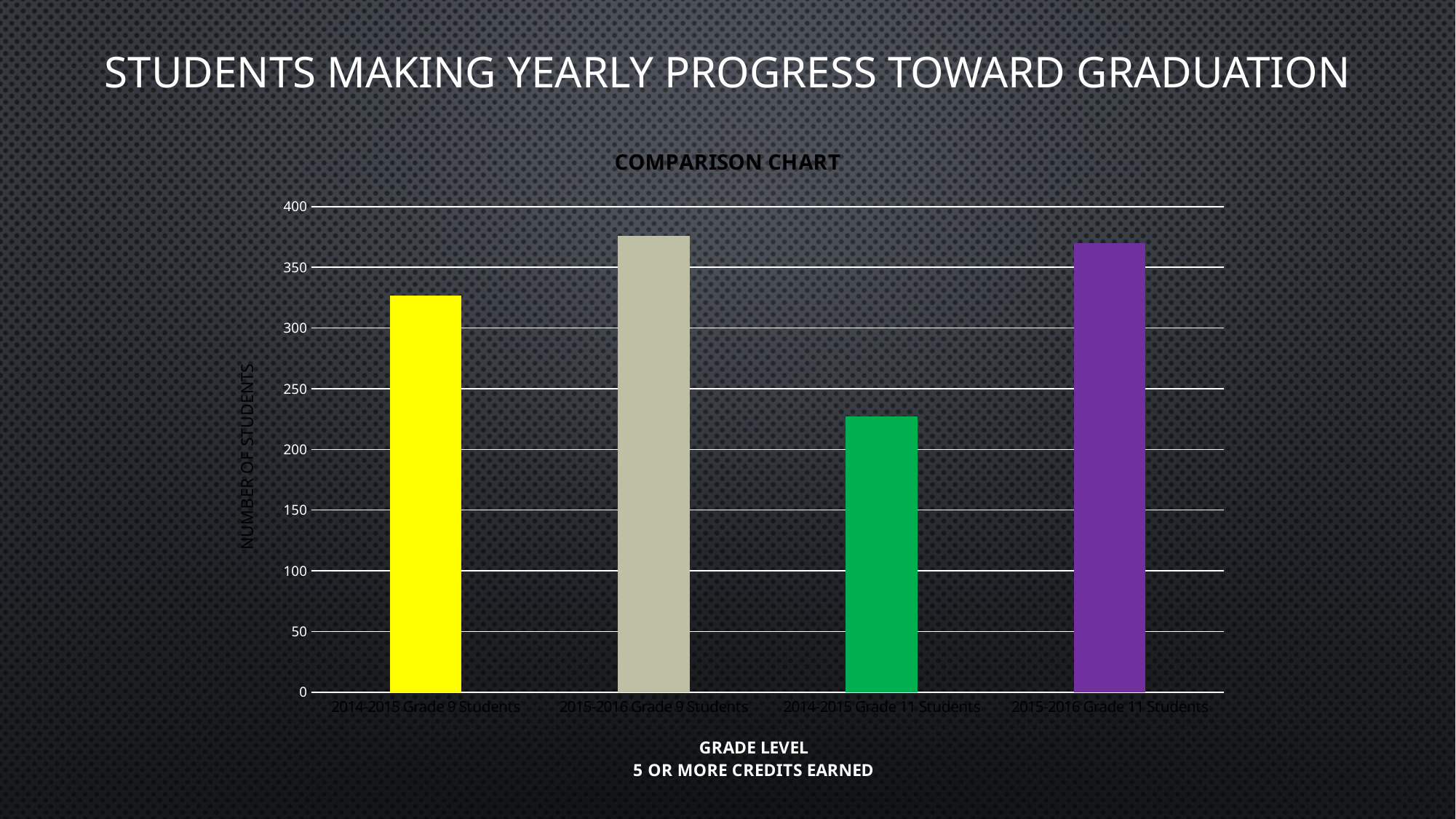
Which category has the lowest number of students? 2014-2015 Grade 11 Students Is the value for 2015-2016 Grade 9 Students greater or less than 350? greater Which is larger, the value for 2014-2015 Grade 9 Students or 2015-2016 Grade 9 Students? 2015-2016 Grade 9 Students Is the value for 2014-2015 Grade 9 Students greater or less than 350? less What is the title of the chart? Comparison Chart What kind of chart is shown on the slide? Bar chart Which is larger, the value for 2014-2015 Grade 11 Students or 2015-2016 Grade 11 Students? 2015-2016 Grade 11 Students Is the value for 2014-2015 Grade 9 Students greater or less than 300? greater How many bars (categories) are plotted in the chart? 4 What is the label on the vertical axis of the chart? Number of Students